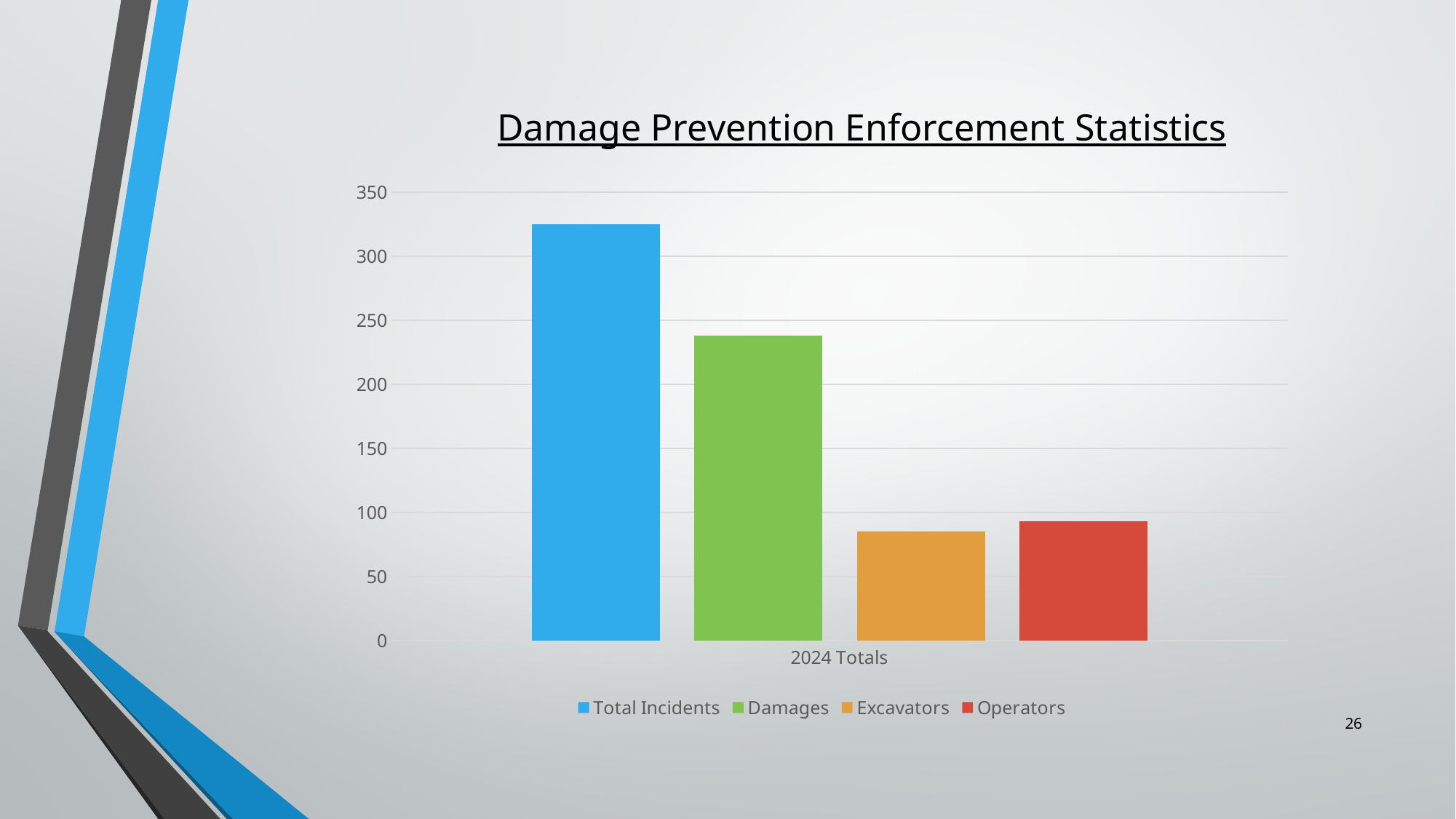
Is the value for Operators greater or less than 50? greater What type of chart is shown on the slide? bar chart What is the category label shown on the x axis? 2024 Totals What is the title of the chart? Damage Prevention Enforcement Statistics How many series does the legend list? 4 Which is larger, the value for Damages or the value for Operators? Damages Is the value for Total Incidents greater or less than 300? greater Is the value for Damages greater or less than 250? less Which is larger, the value for Total Incidents or the value for Damages? Total Incidents Which series has the lowest value? Excavators Which series has the highest value? Total Incidents